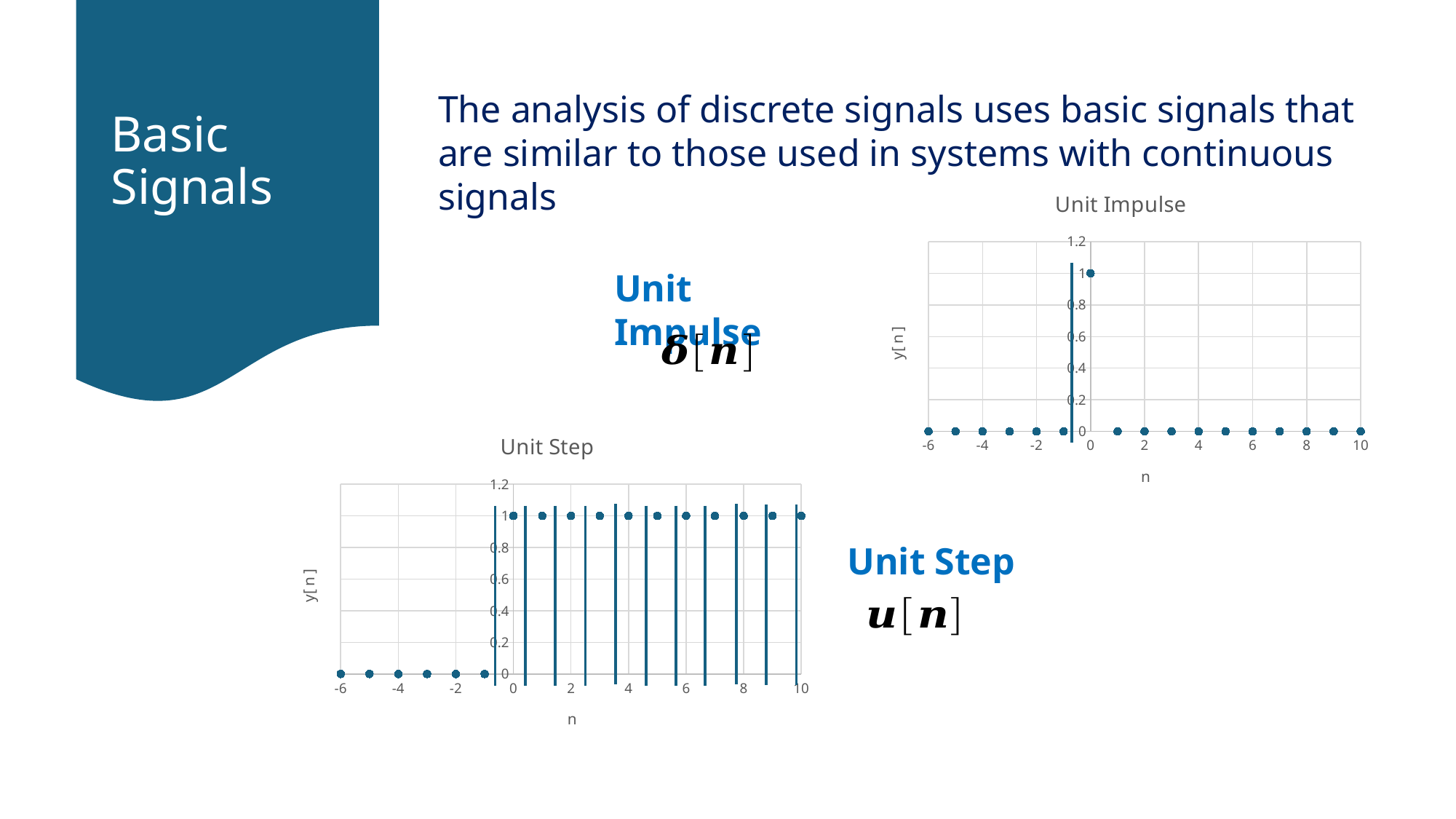
How many data points are plotted in the Unit Step chart? 17 In the Unit Impulse chart, at which value of n is y[n] highest? 0 In the Unit Impulse chart, what is the value of y[n] at n = 4? 0 In the Unit Step chart, is the value at n = 2 larger or smaller than the value at n = -2? larger In the Unit Impulse chart, is the value at n = 0 greater or less than 0.8? greater In the Unit Step chart, do the values rise, fall, or stay constant as n goes from 0 to 10? stay constant In the Unit Step chart, what is the value of y[n] at n = -3? 0 In the Unit Step chart, what is the difference between the value at n = 5 and the value at n = -5? 1 In the Unit Step chart, what is the value of y[n] at n = 6? 1 What is the range of n shown on the x axis of the Unit Impulse chart? -6 to 10 What is the label on the y axis of the Unit Step chart? y[n] In the Unit Impulse chart, what is the value of y[n] at n = 0? 1